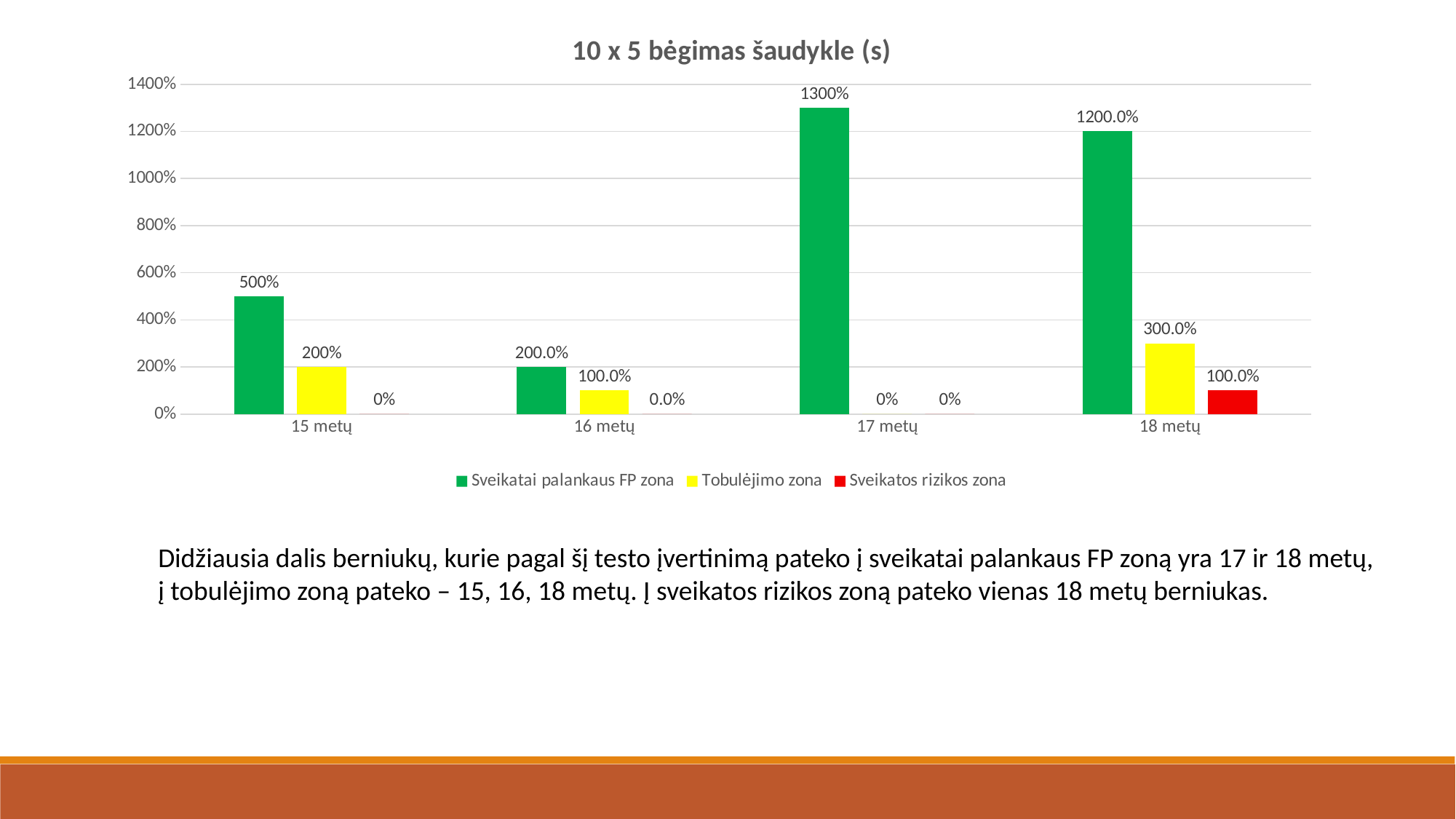
How many series does the legend list? 3 What type of chart is shown on the slide? Bar chart Which age group has the lowest value for Sveikatai palankaus FP zona? 16 metų What is the value of Sveikatos rizikos zona for 18 metų? 100.0% What is the value of Tobulėjimo zona for 18 metų? 300.0% Which age group has the highest value for Sveikatai palankaus FP zona? 17 metų What is the value of Sveikatai palankaus FP zona for 16 metų? 200.0% What is the difference between the Sveikatai palankaus FP zona values for 17 metų and 18 metų? 100% How many age groups are shown on the x axis? 4 Is the value of Sveikatai palankaus FP zona for 15 metų greater or less than 400%? greater What is the value of Sveikatai palankaus FP zona for 17 metų? 1300% Which is larger: the Tobulėjimo zona value for 15 metų or for 16 metų? 15 metų